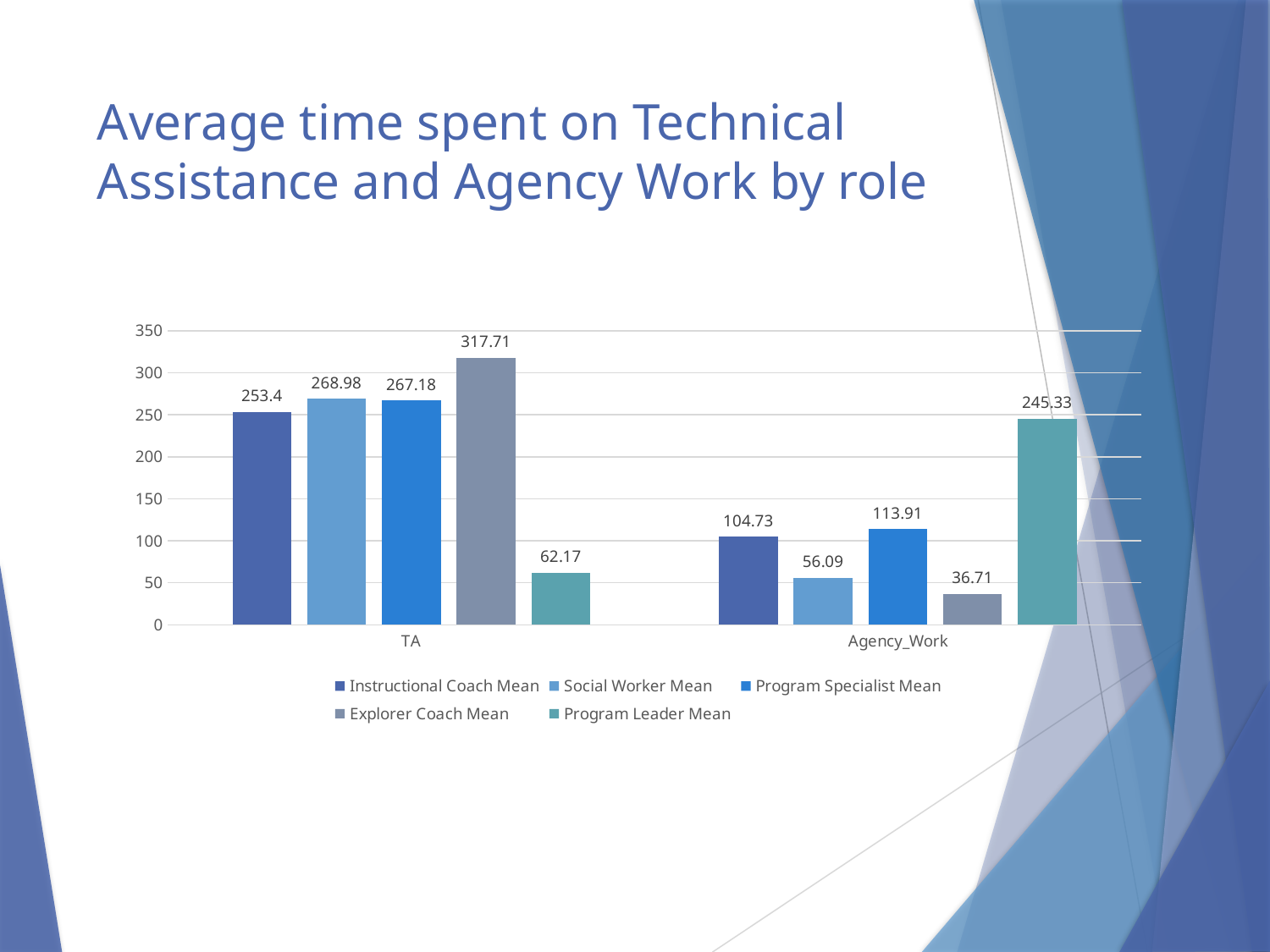
What kind of chart is shown on the slide? Bar chart How many categories are shown on the x axis? 2 What is the title of the slide containing the chart? Average time spent on Technical Assistance and Agency Work by role How many series does the legend list? 5 What is the difference between the Program Leader Mean for Agency_Work and the Program Leader Mean for TA? 183.16 What is the Program Leader Mean value for Agency_Work? 245.33 Which series has the lowest value for Agency_Work? Explorer Coach Mean What is the Explorer Coach Mean value for TA? 317.71 What is the difference between the Explorer Coach Mean for TA and the Explorer Coach Mean for Agency_Work? 281 What is the Social Worker Mean value for Agency_Work? 56.09 Which is larger: the Program Specialist Mean for Agency_Work or the Instructional Coach Mean for Agency_Work? Program Specialist Mean for Agency_Work Which series has the highest value for TA? Explorer Coach Mean